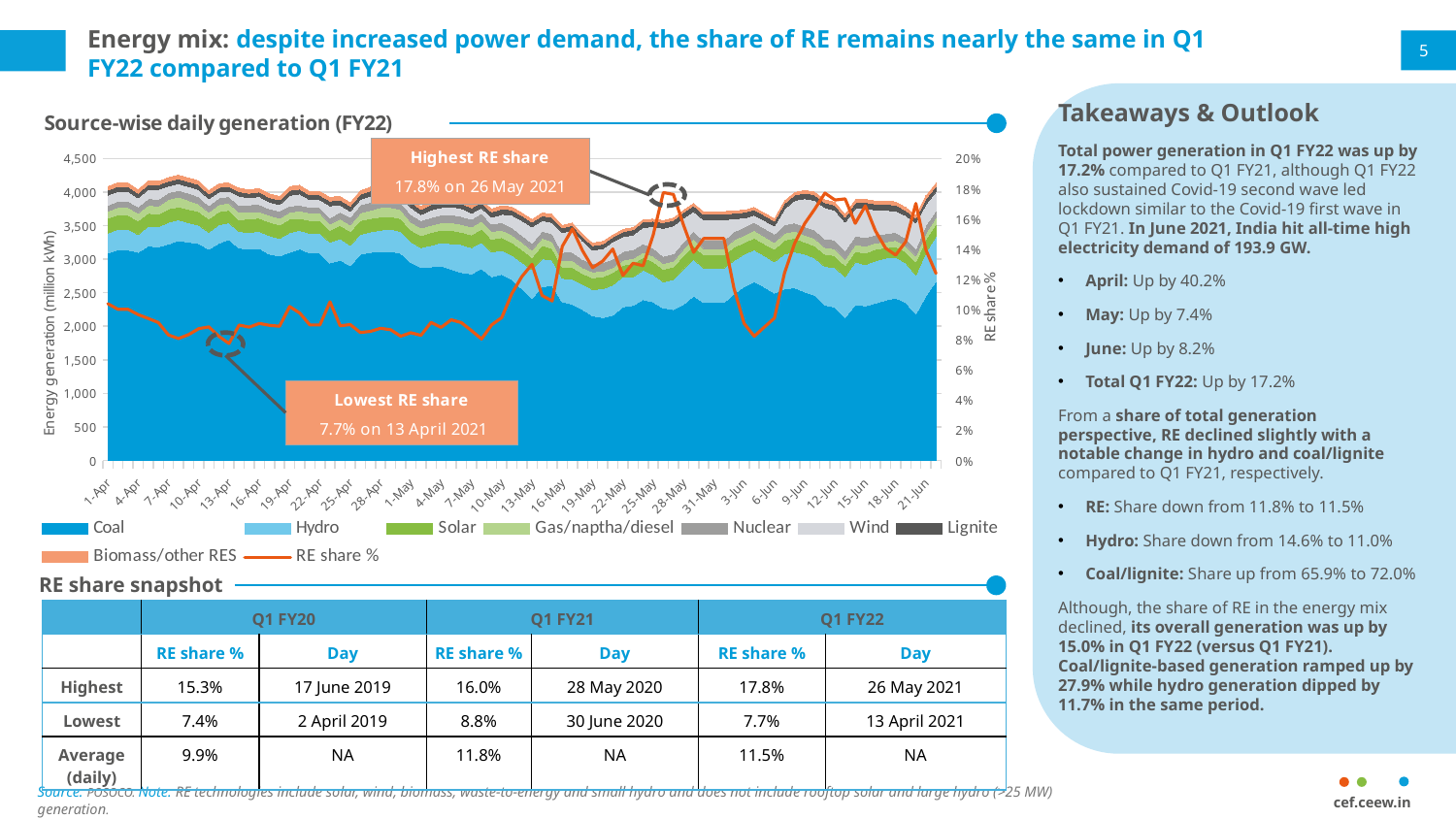
How many series does the legend of the Source-wise daily generation (FY22) chart list? 9 What is the label of the left vertical axis of the Source-wise daily generation (FY22) chart? Energy generation (million kWh) What is the lowest RE share annotated on the Source-wise daily generation (FY22) chart? 7.7% What is the difference between the highest and lowest RE share values annotated on the chart? 10.1 percentage points Which annotated RE share is larger: the one on 26 May 2021 or the one on 13 April 2021? 26 May 2021 On what date did the highest RE share of 17.8% occur, according to the chart annotation? 26 May 2021 What is the highest RE share annotated on the Source-wise daily generation (FY22) chart? 17.8% What kind of chart is the Source-wise daily generation (FY22) chart? Stacked area chart with a line On what date did the lowest RE share of 7.7% occur, according to the chart annotation? 13 April 2021 Is the RE share % on 26 May 2021 greater or less than 16%? greater Is the RE share % on 13 April 2021 greater or less than 10%? less Which series is plotted as the bottom (largest) layer of the stacked area in the chart? Coal